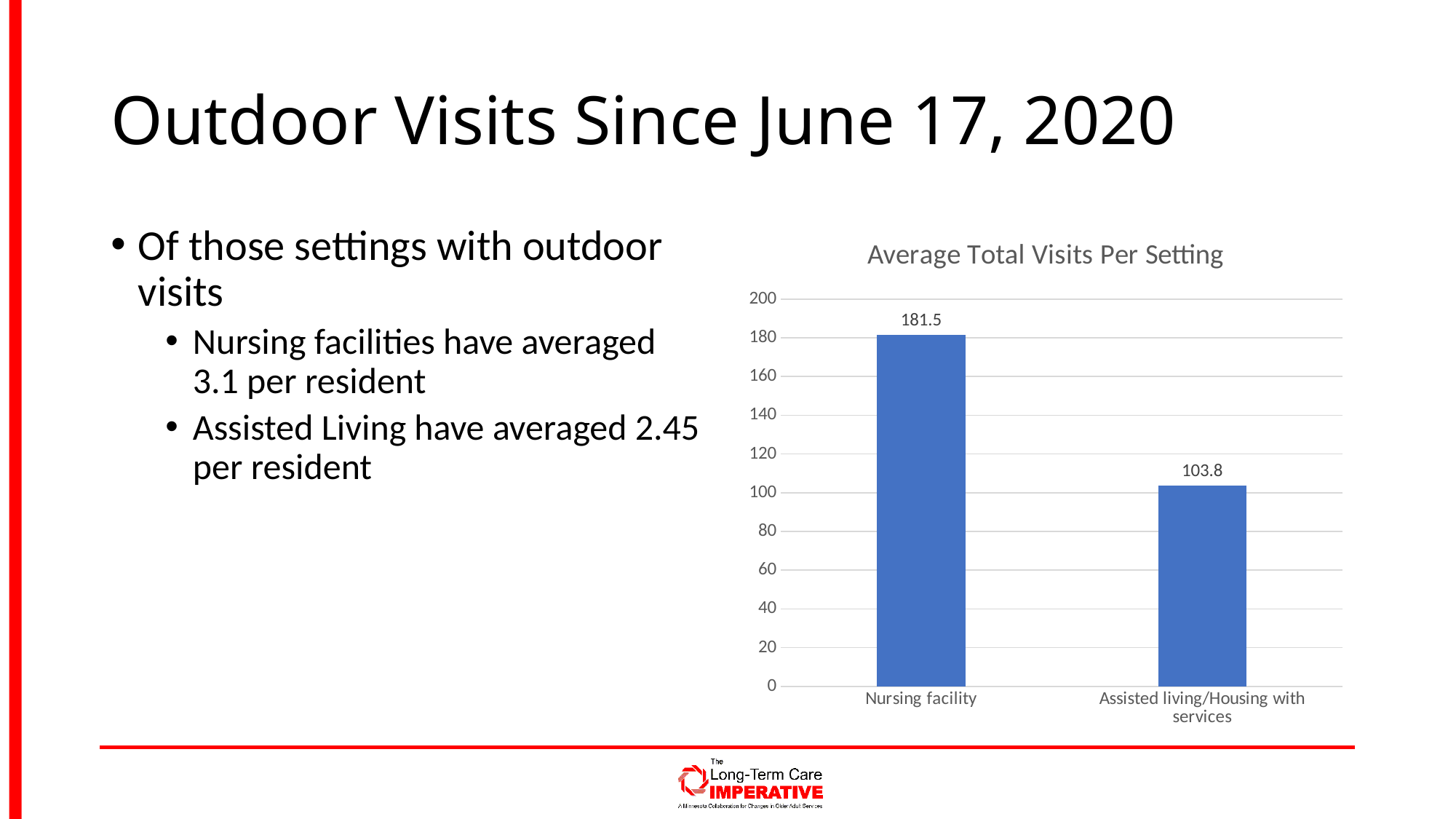
Which setting has the lowest average total visits? Assisted living/Housing with services Which setting has the highest average total visits? Nursing facility What is the average total visits per setting for Nursing facility? 181.5 How many categories are shown in the chart? 2 What is the title of the chart? Average Total Visits Per Setting What kind of chart is shown on the slide? Bar chart What is the difference in average total visits between Nursing facility and Assisted living/Housing with services? 77.7 Is the value for Assisted living/Housing with services greater or less than 120? less What is the maximum value shown on the chart's vertical axis? 200 Is the value for Nursing facility greater or less than 160? greater Which has more average total visits, Nursing facility or Assisted living/Housing with services? Nursing facility What is the average total visits per setting for Assisted living/Housing with services? 103.8